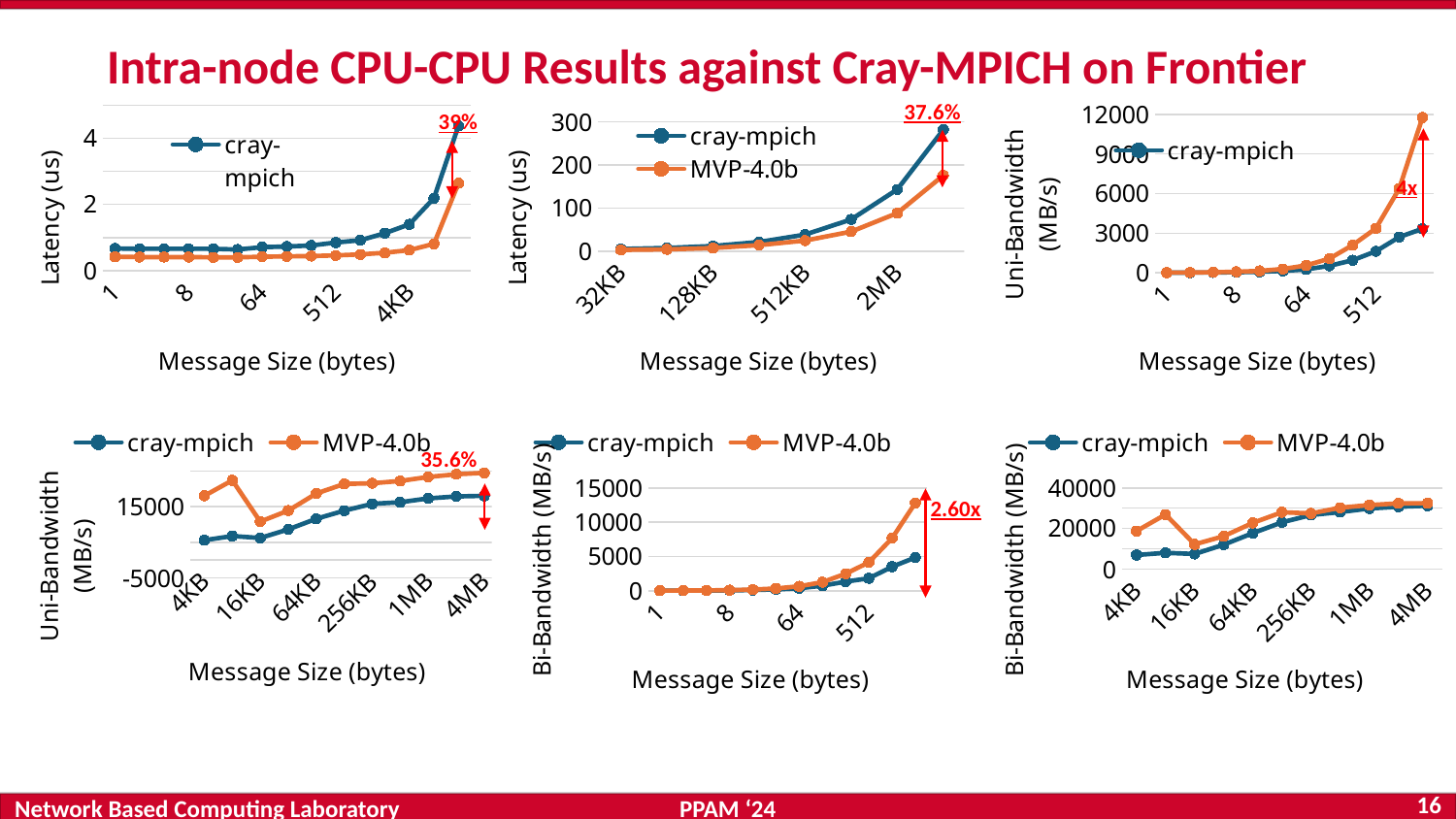
In the top-left latency chart, is the cray-mpich latency at 4KB greater or less than 2? less In the top-middle latency chart, what percentage improvement is annotated at the largest message size? 37.6% What kind of chart is the top-middle chart (latency for 32KB to 2MB message sizes)? line chart In the bottom-right Bi-Bandwidth chart, does the cray-mpich bandwidth generally rise or fall from 4KB to 4MB? rise In the top-right Uni-Bandwidth chart, is the cray-mpich value at 512 bytes greater or less than 3000? less In the top-right Uni-Bandwidth chart, which series has the higher bandwidth at the largest message size, cray-mpich or MVP-4.0b? MVP-4.0b In the top-right Uni-Bandwidth chart, what speedup factor is annotated at the largest message size? 4x In the top-middle latency chart, is the cray-mpich latency at 2MB greater or less than 100? greater In the bottom-left Uni-Bandwidth chart, which series has the higher bandwidth at 16KB, cray-mpich or MVP-4.0b? MVP-4.0b How many series does the legend of the top-middle latency chart list? 2 In the top-middle latency chart, does latency rise or fall as message size increases? rise